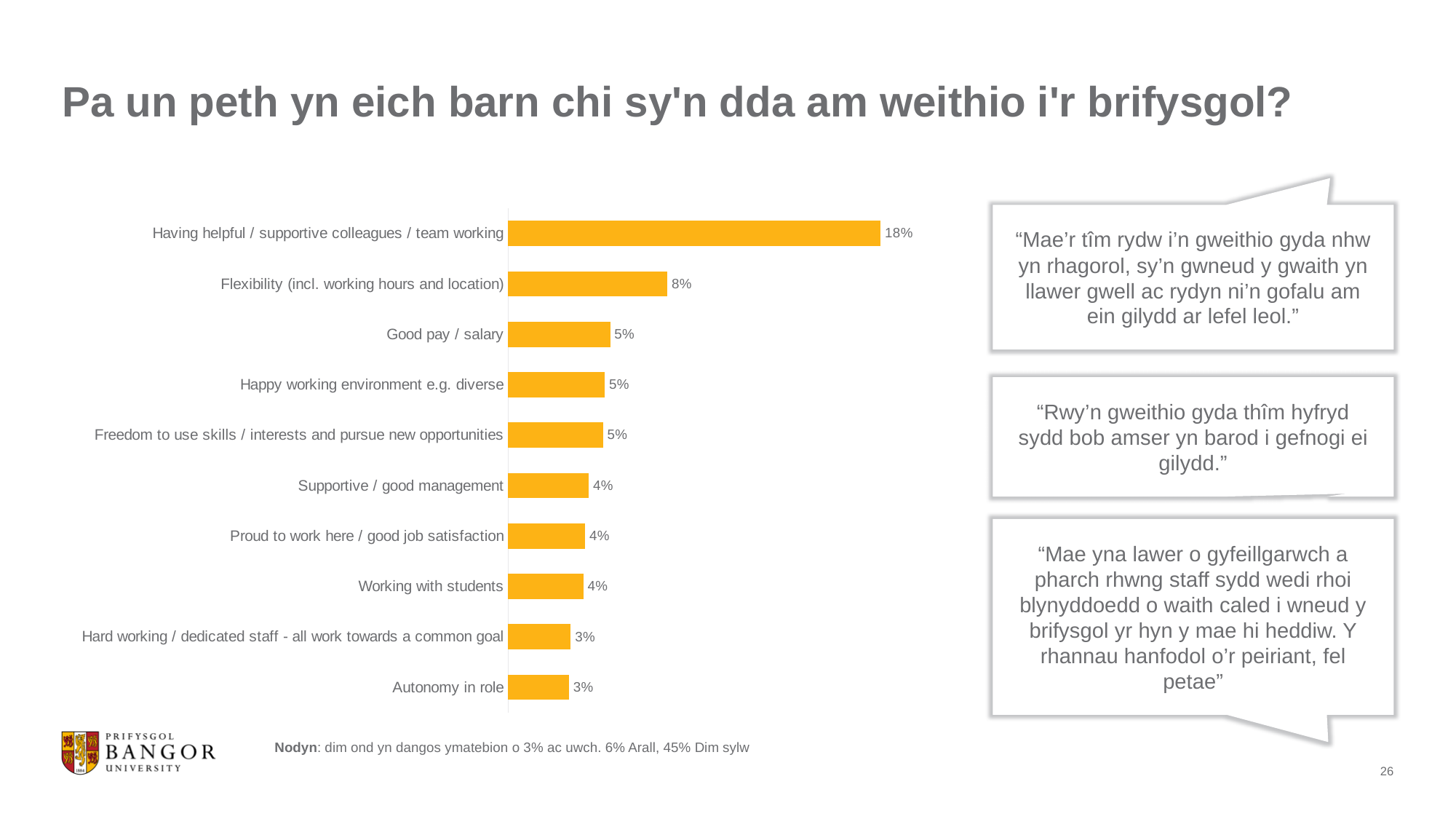
Which category has the highest value in the chart? Having helpful / supportive colleagues / team working How many categories are shown in the bar chart? 10 What value is shown for 'Autonomy in role'? 3% What kind of chart is shown on the slide? Bar chart What colour are the bars in the chart? Orange What is the difference between the values for 'Flexibility (incl. working hours and location)' and 'Hard working / dedicated staff - all work towards a common goal'? 5% What percentage is shown for 'Working with students'? 4% Which is larger: the value for 'Good pay / salary' or the value for 'Supportive / good management'? Good pay / salary How many categories in the chart have a value of 5%? 3 What percentage is shown for 'Having helpful / supportive colleagues / team working'? 18% What value is shown for 'Flexibility (incl. working hours and location)'? 8% What is the difference between the values for 'Having helpful / supportive colleagues / team working' and 'Flexibility (incl. working hours and location)'? 10%